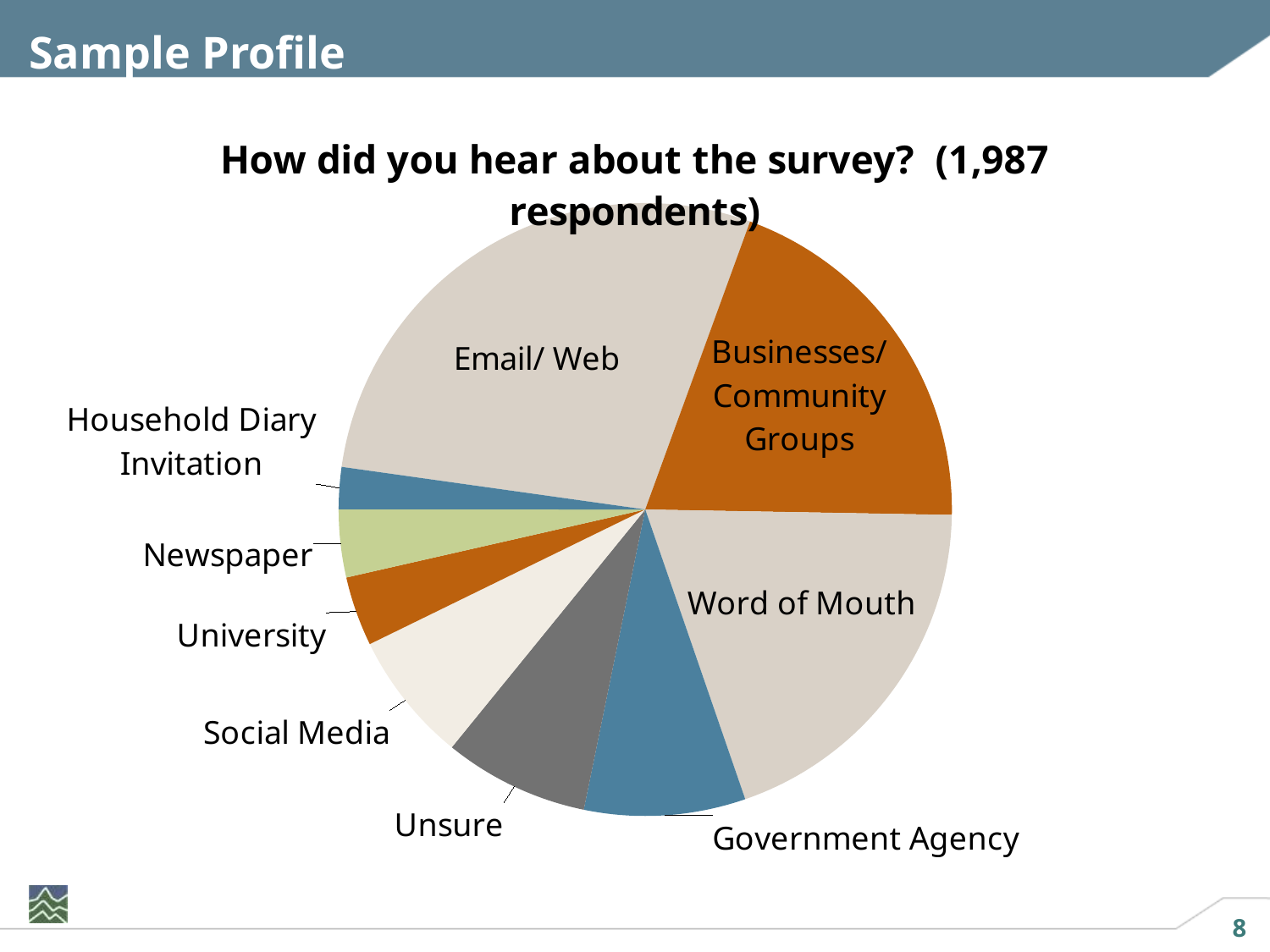
How many respondents does the chart title say answered the survey? 1,987 Which category has the largest slice of the pie chart? Email/ Web Which is larger, the slice for Word of Mouth or the slice for Unsure? Word of Mouth What is the title of the pie chart? How did you hear about the survey? (1,987 respondents) Which is larger, the slice for Government Agency or the slice for Household Diary Invitation? Government Agency Which is larger, the slice for Businesses/ Community Groups or the slice for Social Media? Businesses/ Community Groups How many categories (slices) does the pie chart have? 9 What kind of chart is shown on the slide? Pie chart